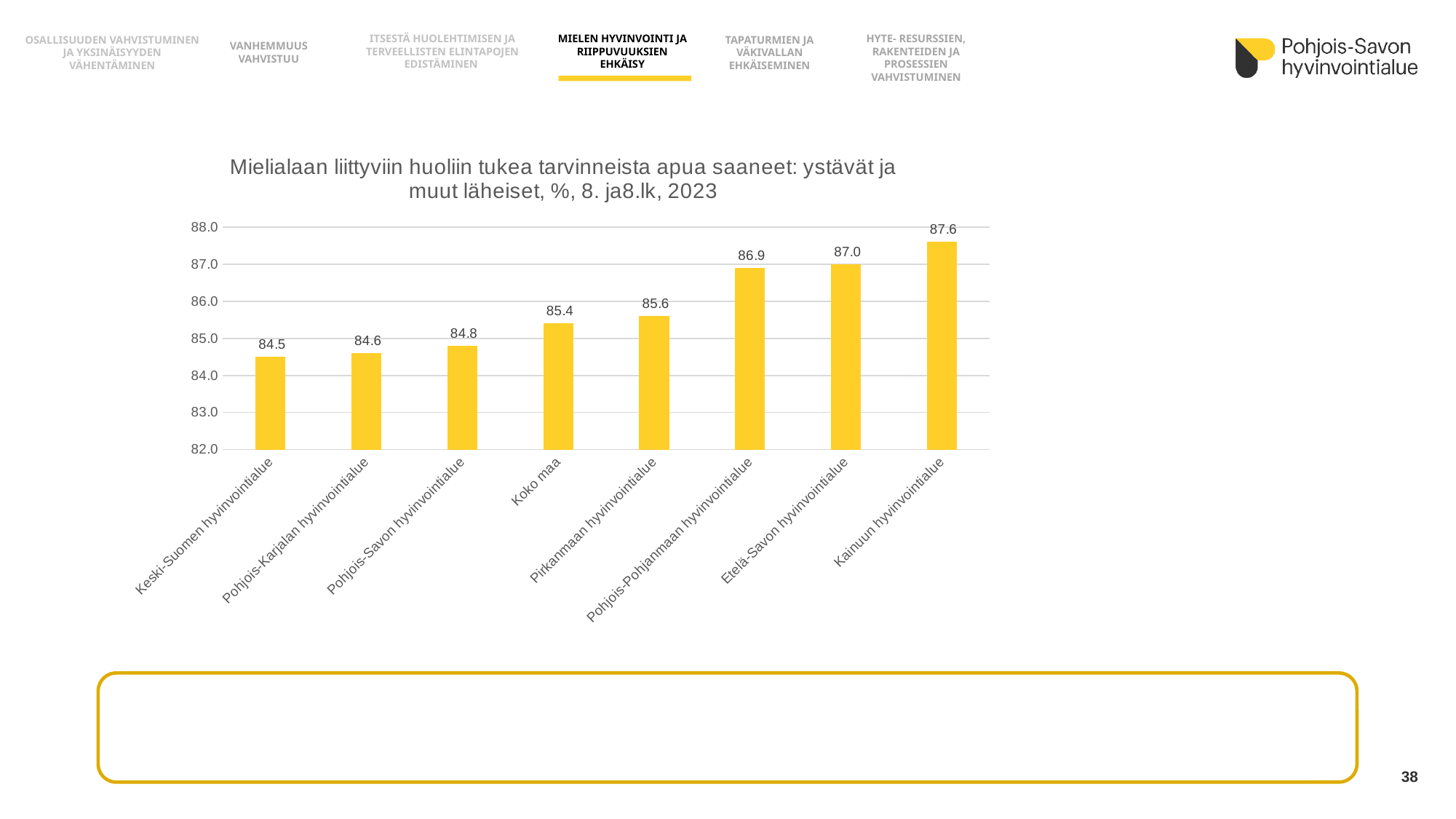
What is the value for Koko maa? 85.4 How many categories are shown on the x axis? 8 What is the value for Pohjois-Savon hyvinvointialue? 84.8 Which is larger, the value for Pirkanmaan hyvinvointialue or the value for Pohjois-Karjalan hyvinvointialue? Pirkanmaan hyvinvointialue What colour are the bars in the chart? yellow Is the value for Pohjois-Pohjanmaan hyvinvointialue greater or less than 86.0? greater What kind of chart is shown on the slide? bar chart Do the values rise or fall from left to right along the x axis? rise Which category has the highest value? Kainuun hyvinvointialue Which category has the lowest value? Keski-Suomen hyvinvointialue What is the value for Etelä-Savon hyvinvointialue? 87.0 What is the difference between the values for Kainuun hyvinvointialue and Keski-Suomen hyvinvointialue? 3.1